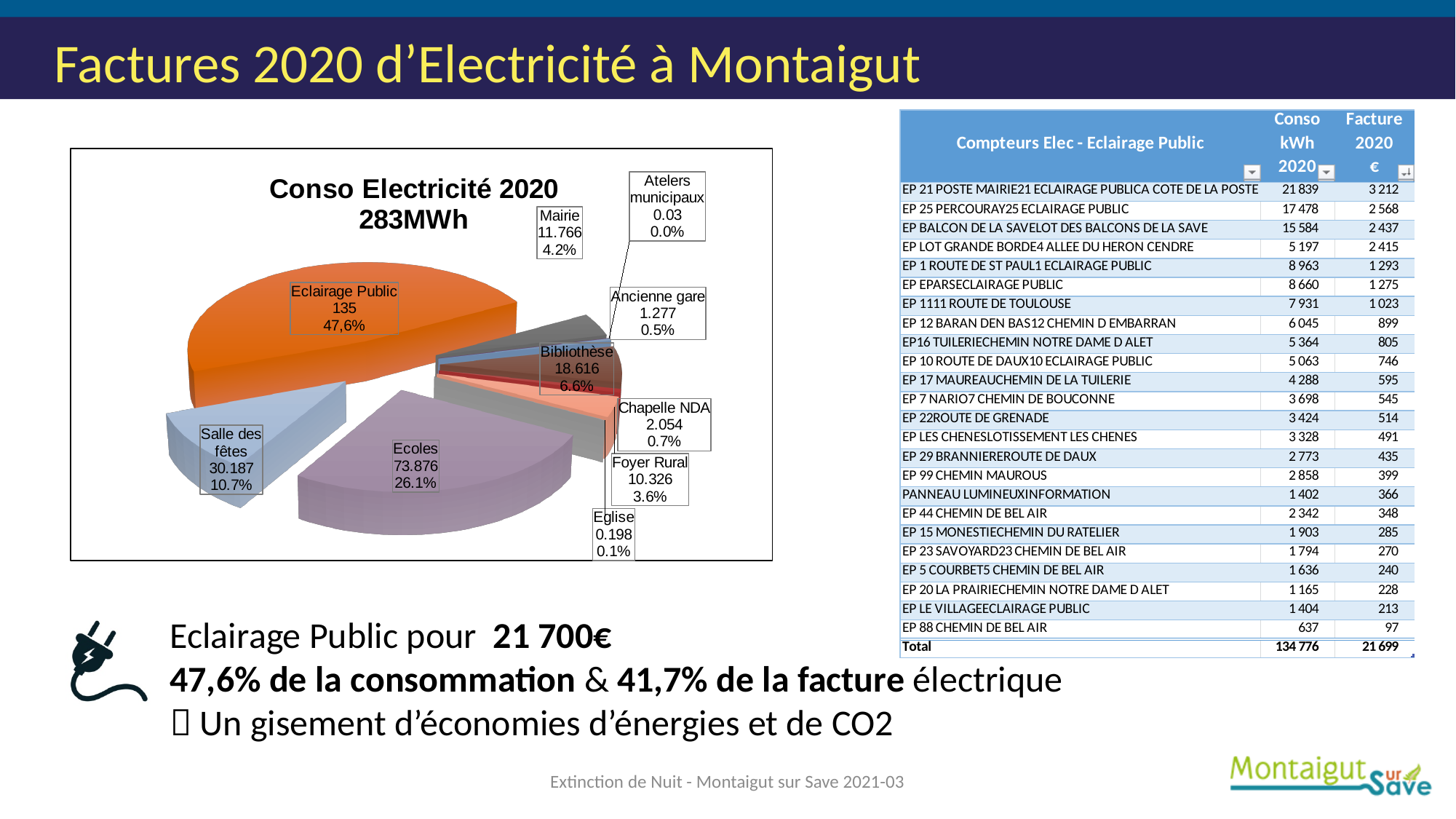
What share of the pie does Eclairage Public represent? 47,6% What kind of chart is shown on the slide? pie chart What is the value shown for Foyer Rural in the pie chart? 10.326 What share of the pie does Mairie represent? 4.2% What share of the pie does Ecoles represent? 26.1% What is the value shown for Bibliothèque in the pie chart? 18.616 Which category has the smallest slice in the pie chart? Atelers municipaux Which category has the largest slice in the pie chart? Eclairage Public How many slices does the pie chart have? 10 What is the title of the pie chart? Conso Electricité 2020 283MWh What is the value shown for Salle des fêtes in the pie chart? 30.187 Which is larger in the pie chart, Ecoles or Salle des fêtes? Ecoles